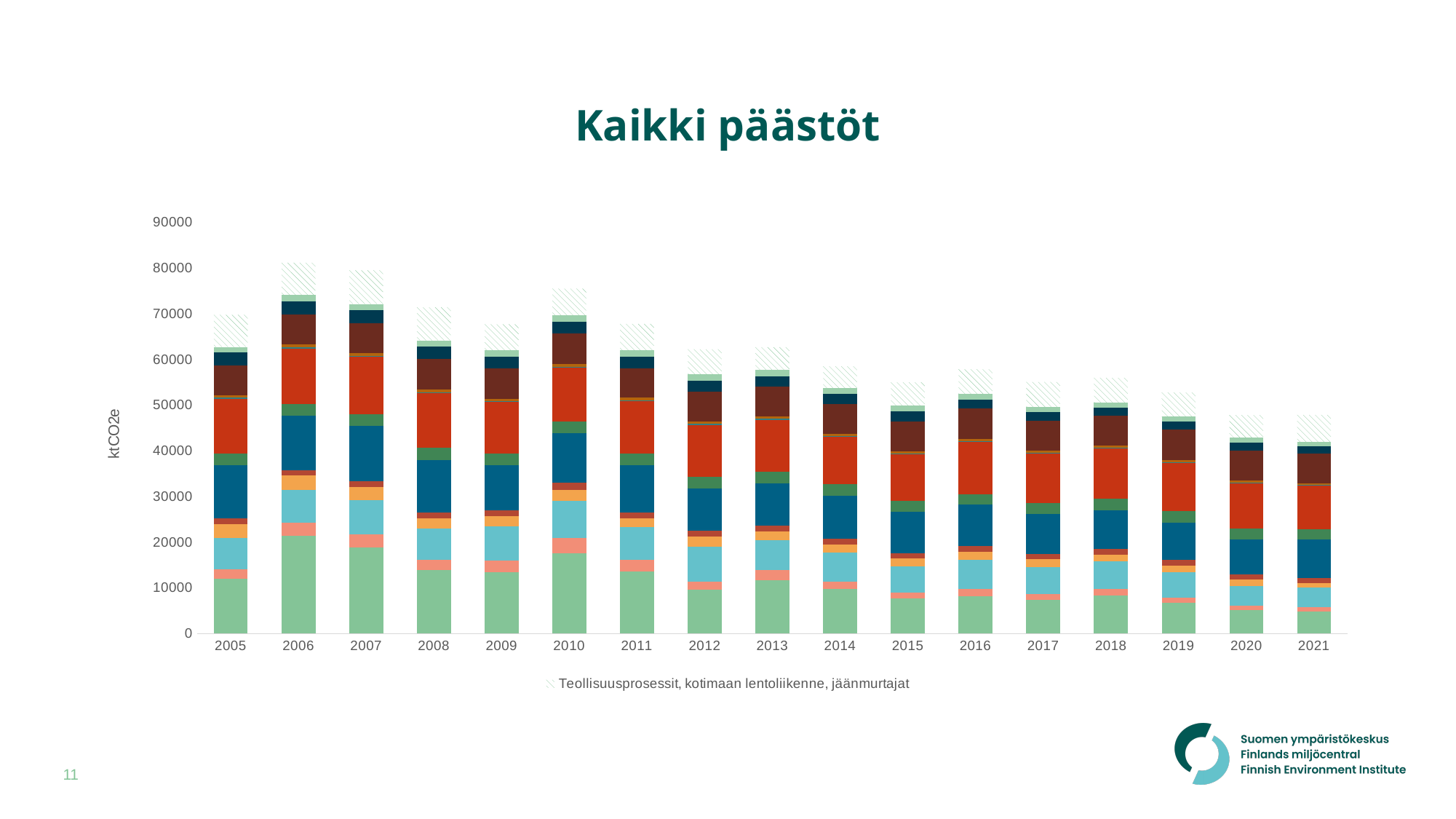
What is the title of the chart? Kaikki päästöt What kind of chart is shown on the slide? Stacked bar chart Is the total for 2021 greater or less than 50000? less Is the total for 2005 greater or less than 60000? greater Do the total emissions generally rise or fall from 2005 to 2021? fall Which year has the taller total bar, 2007 or 2008? 2007 Which year has the taller total bar, 2010 or 2011? 2010 Which year has the highest total bar in the chart? 2006 Is the total for 2010 greater or less than 70000? greater How many years are shown along the x axis of the chart? 17 What unit is shown on the y-axis label of the chart? ktCO2e